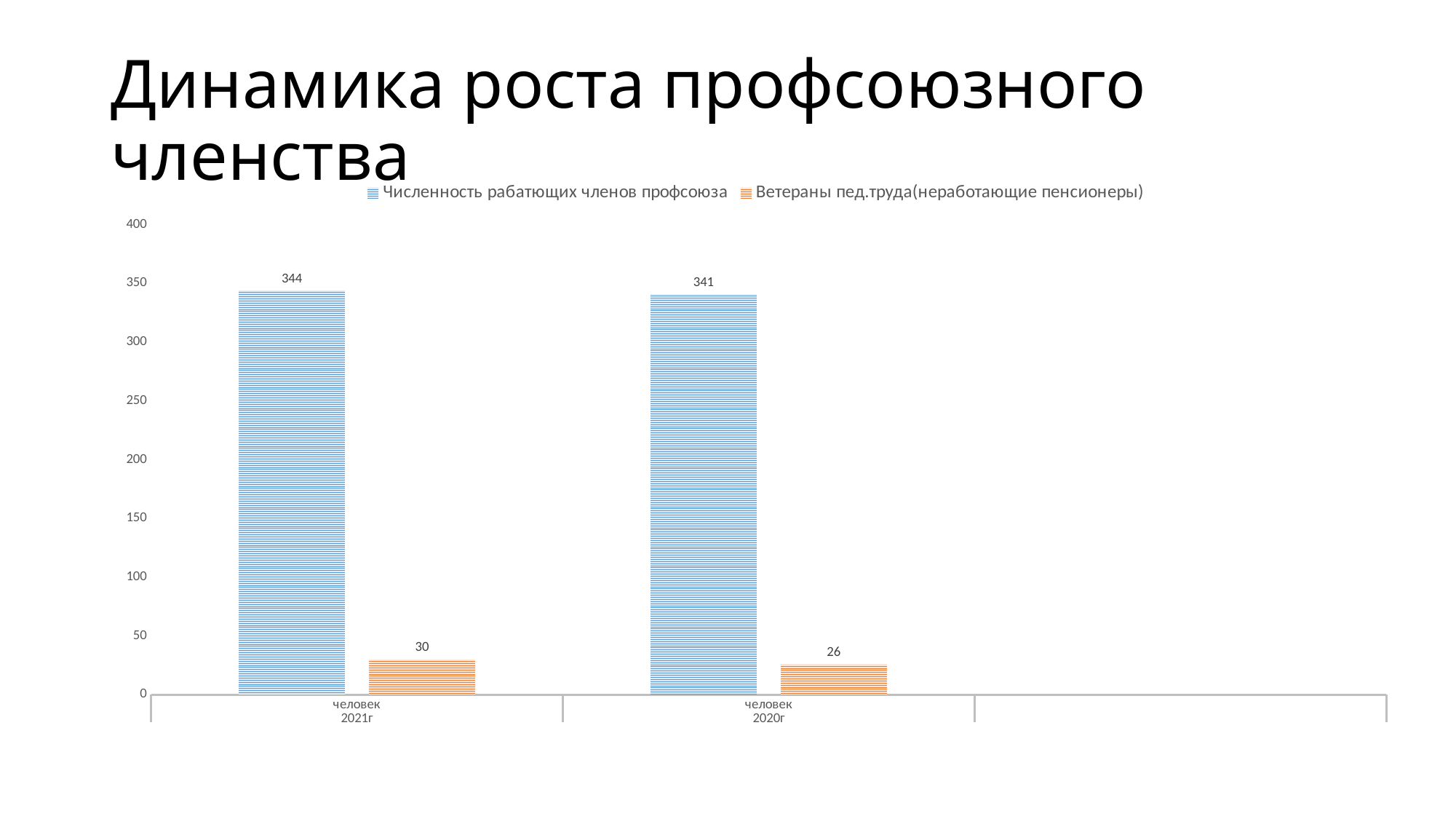
What is the difference between the 'Численность рабатющих членов профсоюза' values for 2021г and 2020г? 3 What is the value of 'Ветераны пед.труда(неработающие пенсионеры)' for 2021г? 30 What is the difference between the 'Ветераны пед.труда(неработающие пенсионеры)' values for 2021г and 2020г? 4 How many series does the legend list? 2 What colour are the bars for 'Ветераны пед.труда(неработающие пенсионеры)'? Orange Which year has the higher value for 'Ветераны пед.труда(неработающие пенсионеры)', 2021г or 2020г? 2021г What kind of chart is shown on the slide? Bar chart What is the value of 'Ветераны пед.труда(неработающие пенсионеры)' for 2020г? 26 Is the value for 'Ветераны пед.труда(неработающие пенсионеры)' in 2021г greater or less than 50? less What is the value of 'Численность рабатющих членов профсоюза' for 2020г? 341 What is the value of 'Численность рабатющих членов профсоюза' for 2021г? 344 Is the value for 'Численность рабатющих членов профсоюза' in 2020г greater or less than 300? greater